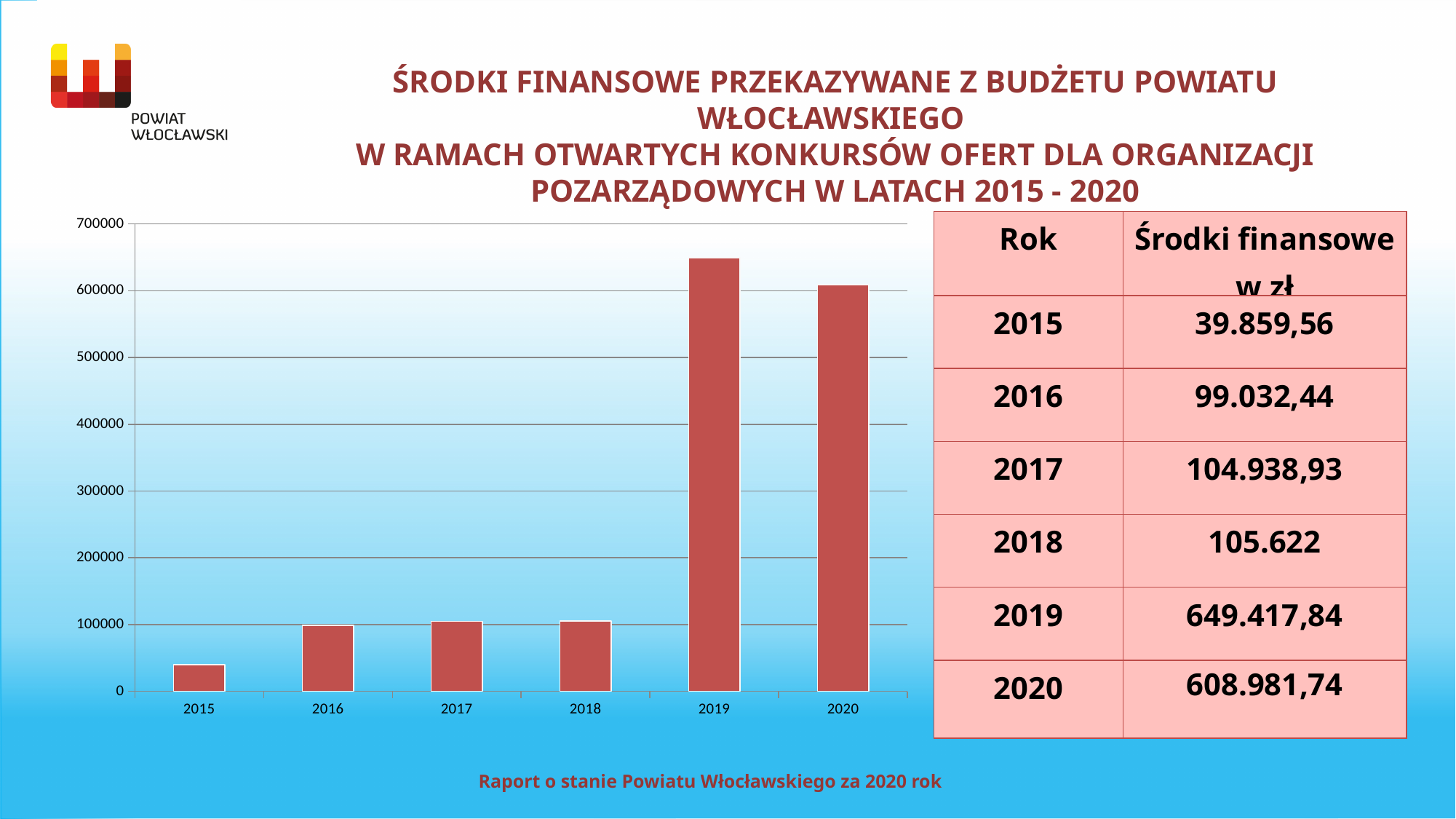
Which year has the lowest value on the chart? 2015 What kind of chart is shown on the slide? bar chart Which is larger, the value for 2019 or the value for 2020? 2019 What is the value (in zł) for 2018? 105.622 Which year has the highest value on the chart? 2019 What is the difference between the values for 2019 and 2020? 40.436,10 Do the values generally rise or fall from 2015 to 2019? rise Is the value for 2015 greater or less than 100000? less How many years are plotted on the chart? 6 Is the value for 2019 greater or less than 600000? greater What is the highest value shown on the vertical axis? 700000 What is the value (in zł) for 2020? 608.981,74